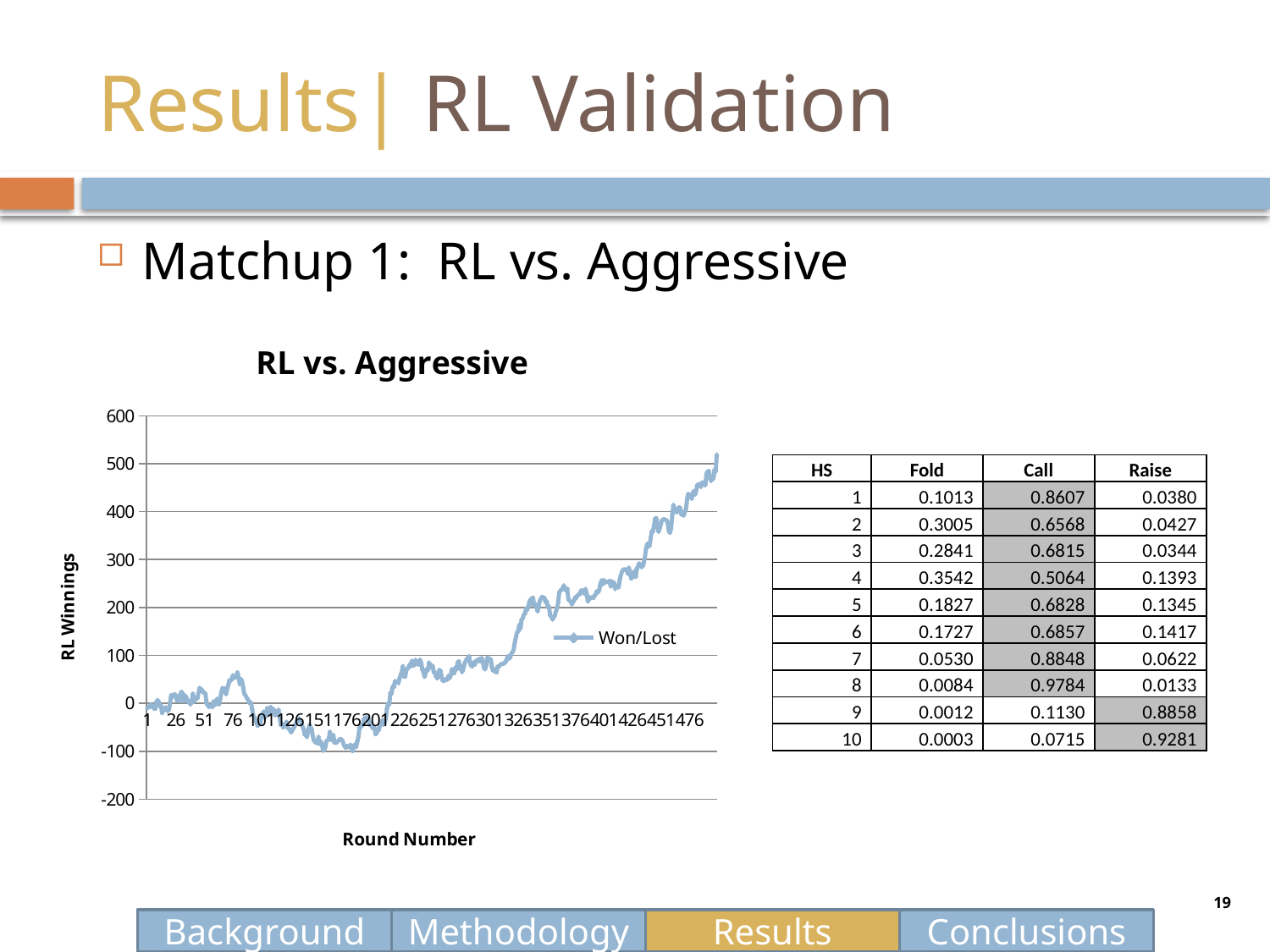
Is the Won/Lost value at round 176 greater or less than -200? greater Is the Won/Lost value at round 251 greater or less than 0? greater Is the Won/Lost value at round 476 greater or less than 400? greater Overall, do the RL Winnings values rise or fall as the round number increases? rise How many series does the chart's legend list? 1 What is the name of the series shown in the chart's legend? Won/Lost What kind of chart is shown on the slide? line chart What is the title of the chart? RL vs. Aggressive